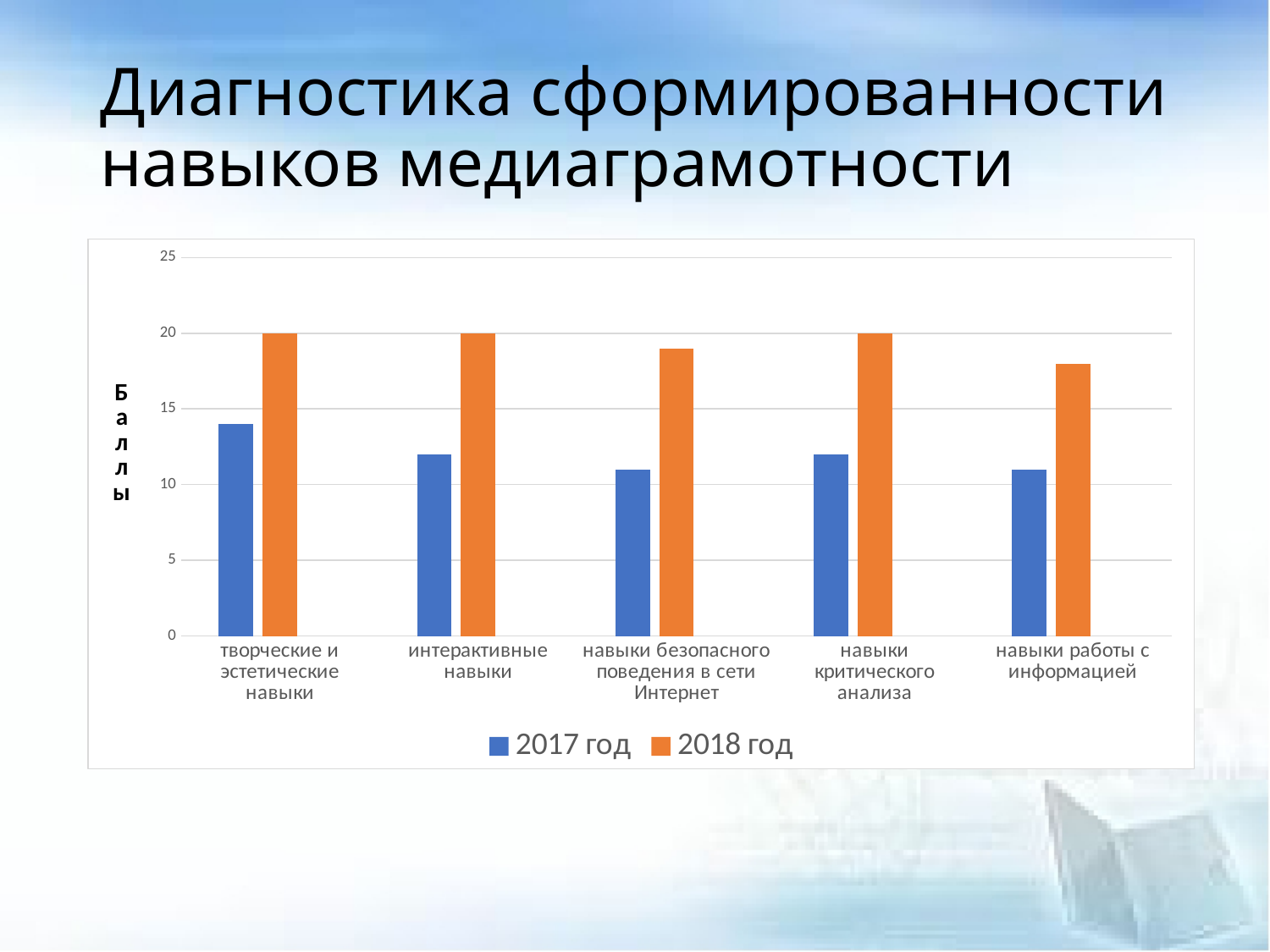
What is the value for 2018 год for творческие и эстетические навыки? 20 Which category has the highest value for 2017 год? творческие и эстетические навыки How many categories are shown on the x axis? 5 What is the value for 2018 год for навыки критического анализа? 20 Is the value for 2017 год for навыки безопасного поведения в сети Интернет greater or less than 10? greater How many series does the legend list? 2 Which is larger for навыки работы с информацией: the value for 2017 год or for 2018 год? 2018 год Is the value for 2018 год for навыки работы с информацией greater or less than 15? greater What kind of chart is shown on the slide? bar chart What is the value for 2018 год for интерактивные навыки? 20 Is the value for 2017 год for творческие и эстетические навыки greater or less than 15? less What is the label on the vertical axis? Баллы